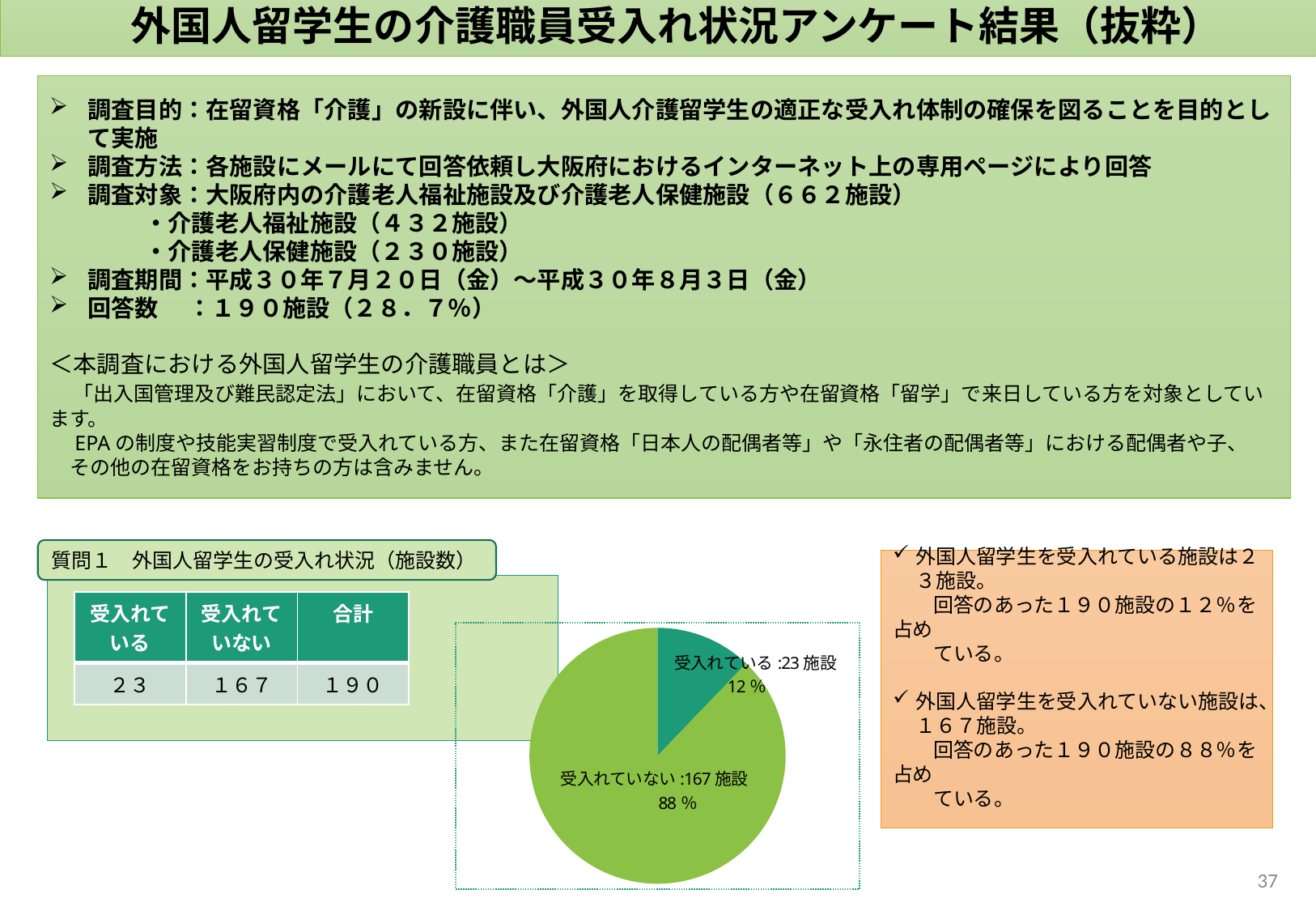
Which slice of the pie chart is the largest? 受入れていない How many facilities does the 受入れていない slice represent? 167施設 What share of the pie does 受入れていない represent? 88% How many slices does the pie chart have? 2 What share of the pie does 受入れている represent? 12% How many facilities does the 受入れている slice represent? 23施設 What is the difference in number of facilities between 受入れていない and 受入れている? 144 What is the total number of facilities represented by the two slices of the pie chart? 190 What colour is the 受入れていない slice of the pie chart? green Which slice of the pie chart is the smallest? 受入れている Which is larger, the 受入れている slice or the 受入れていない slice? 受入れていない What kind of chart is shown on the slide? pie chart